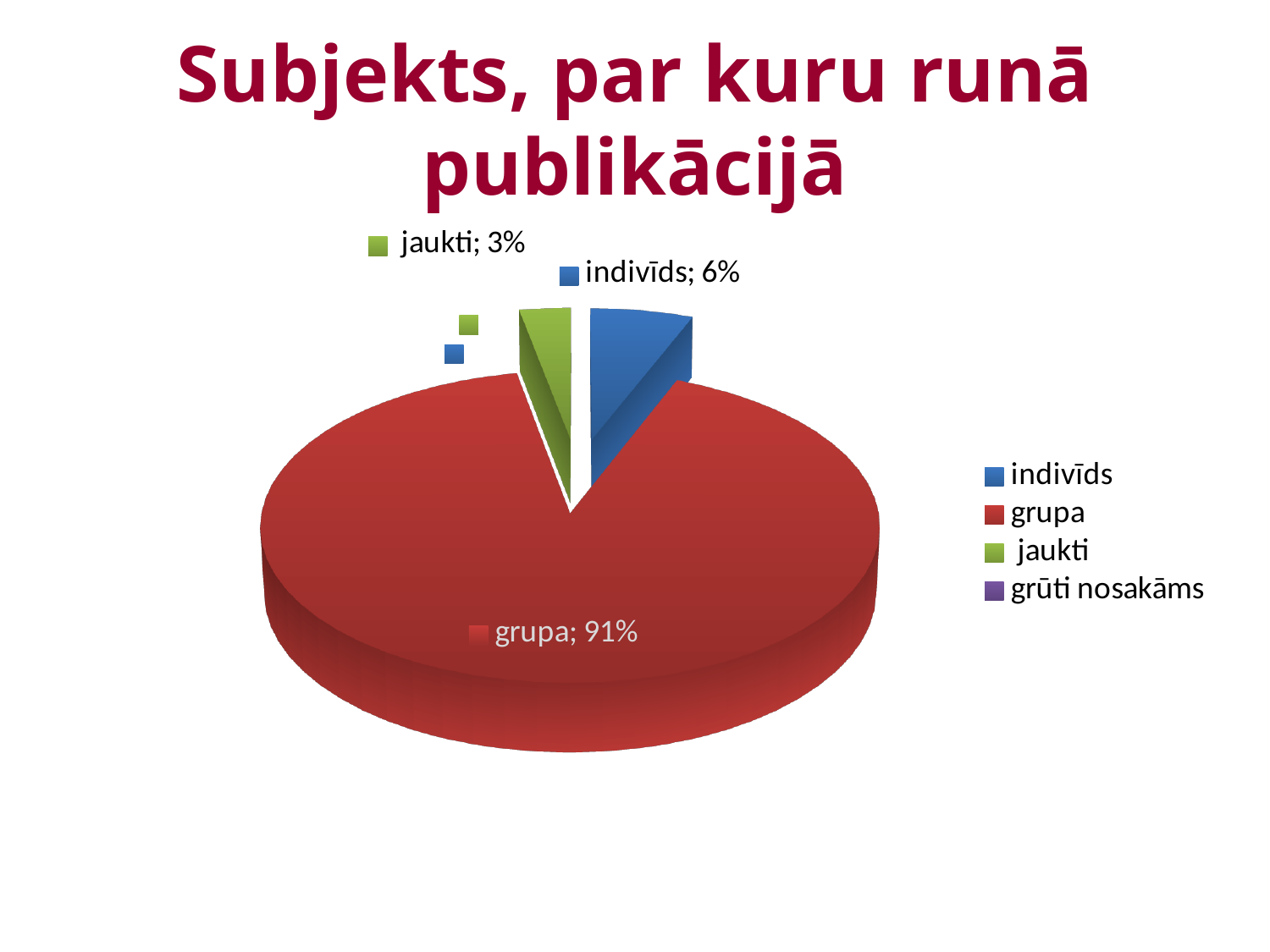
What share of the pie does "indivīds" have? 6% How many entries does the legend list? 4 Which of the labelled slices is the smallest? jaukti What kind of chart is shown on the slide? pie chart What is the title of the chart? Subjekts, par kuru runā publikācijā What share of the pie does "grupa" have? 91% Which category has the largest slice of the pie? grupa Which is larger, the slice for "indivīds" or the slice for "jaukti"? indivīds What colour is the "grupa" slice? red What is the difference in percentage points between "indivīds" and "jaukti"? 3 What share of the pie does "jaukti" have? 3% What is the difference in percentage points between "grupa" and "indivīds"? 85